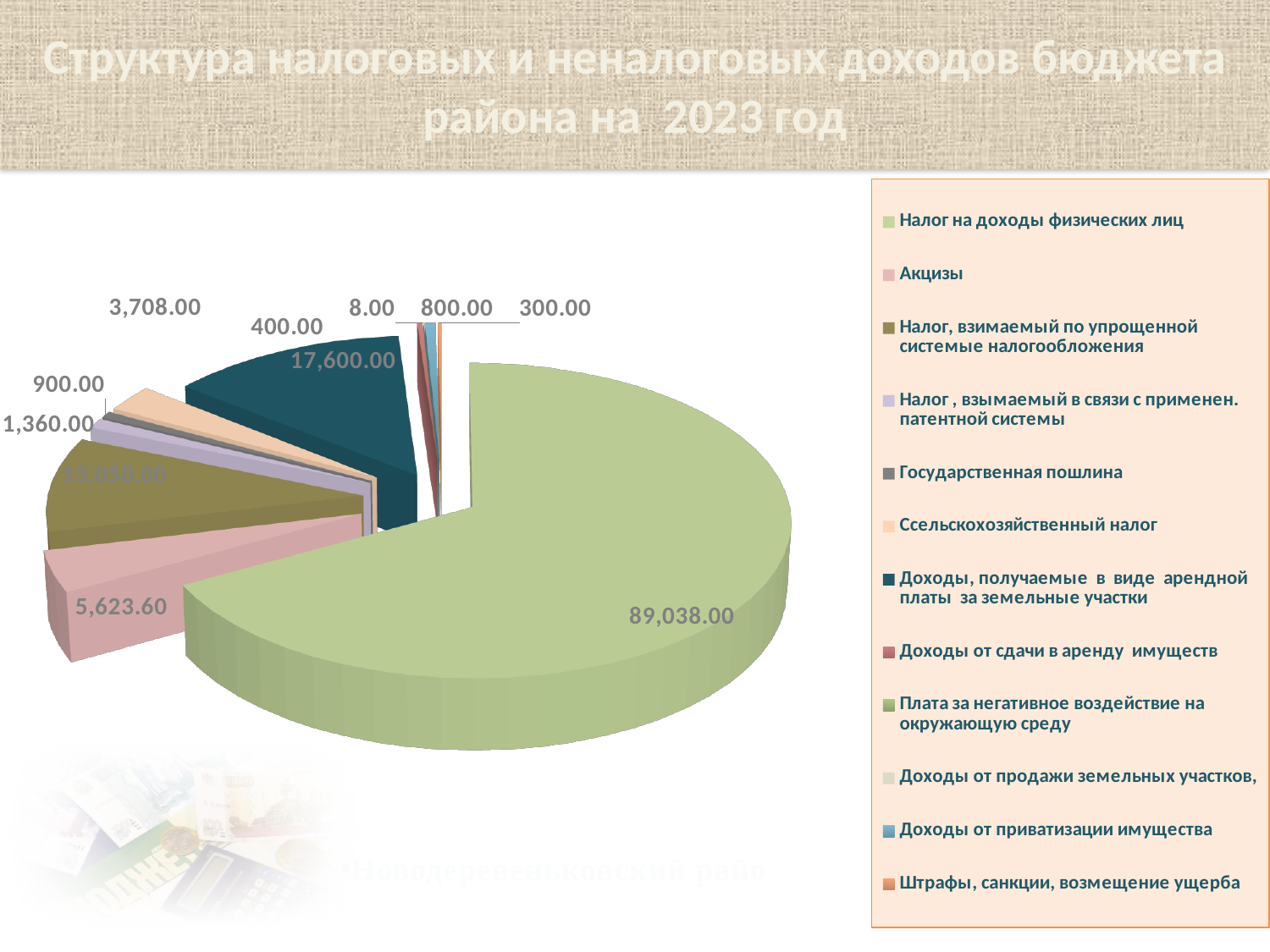
What year does the chart title say the budget structure refers to? 2023 How many categories does the legend of the pie chart list? 12 What is the smallest data label value shown on the pie chart? 8.00 What is the difference between the value for Налог на доходы физических лиц and the value for Доходы, получаемые в виде арендной платы за земельные участки? 71,438.00 Which category has the largest slice in the pie chart? Налог на доходы физических лиц What is the value shown for Акцизы? 5,623.60 What is the value shown for Налог, взимаемый по упрощенной системе налогообложения? 13,050.00 What is the value shown for Налог на доходы физических лиц? 89,038.00 What type of chart is shown on the slide? pie chart Which is larger: the value for Акцизы or the value for Налог, взимаемый по упрощенной системе налогообложения? Налог, взимаемый по упрощенной системе налогообложения What is the value shown for Ссельскохозяйственный налог? 3,708.00 What is the value shown for Доходы, получаемые в виде арендной платы за земельные участки? 17,600.00